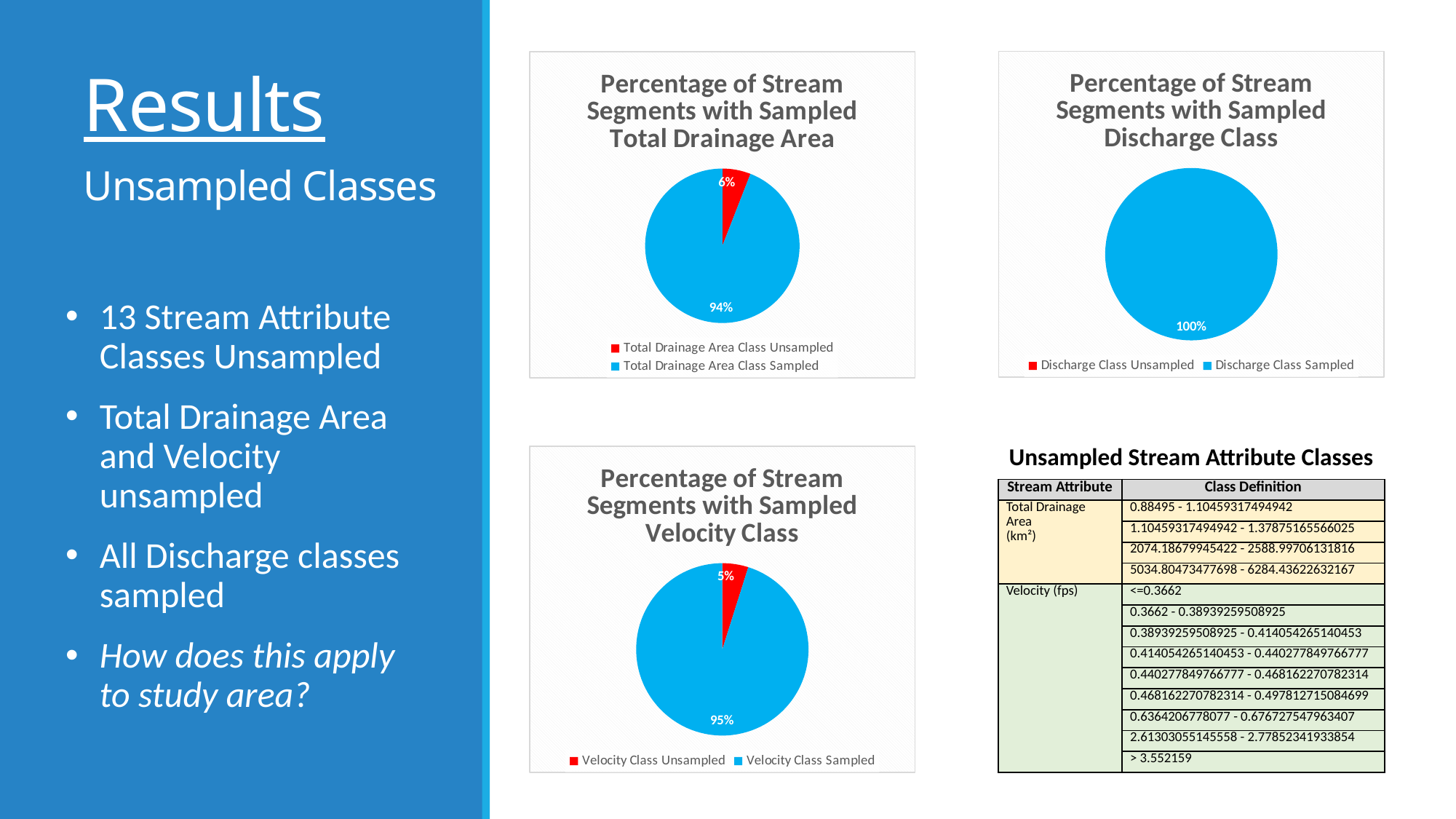
In the 'Percentage of Stream Segments with Sampled Total Drainage Area' chart, what colour is the Total Drainage Area Class Unsampled slice? Red In the 'Percentage of Stream Segments with Sampled Discharge Class' chart, what percentage is shown for Discharge Class Sampled? 100% In the 'Percentage of Stream Segments with Sampled Total Drainage Area' chart, what percentage is shown for Total Drainage Area Class Sampled? 94% In the 'Percentage of Stream Segments with Sampled Velocity Class' chart, which slice is the largest? Velocity Class Sampled In the 'Percentage of Stream Segments with Sampled Velocity Class' chart, what percentage is shown for Velocity Class Unsampled? 5% What type of chart is the 'Percentage of Stream Segments with Sampled Discharge Class' chart? Pie chart In the 'Percentage of Stream Segments with Sampled Total Drainage Area' chart, what is the difference between the Sampled and Unsampled percentages? 88% In the 'Percentage of Stream Segments with Sampled Velocity Class' chart, what percentage is shown for Velocity Class Sampled? 95% In the 'Percentage of Stream Segments with Sampled Total Drainage Area' chart, what percentage is shown for Total Drainage Area Class Unsampled? 6% Which is larger: the Unsampled share in the Total Drainage Area chart or the Unsampled share in the Velocity Class chart? Total Drainage Area chart In the 'Percentage of Stream Segments with Sampled Total Drainage Area' chart, which slice is the smallest? Total Drainage Area Class Unsampled How many entries does the legend of the 'Percentage of Stream Segments with Sampled Velocity Class' chart list? 2